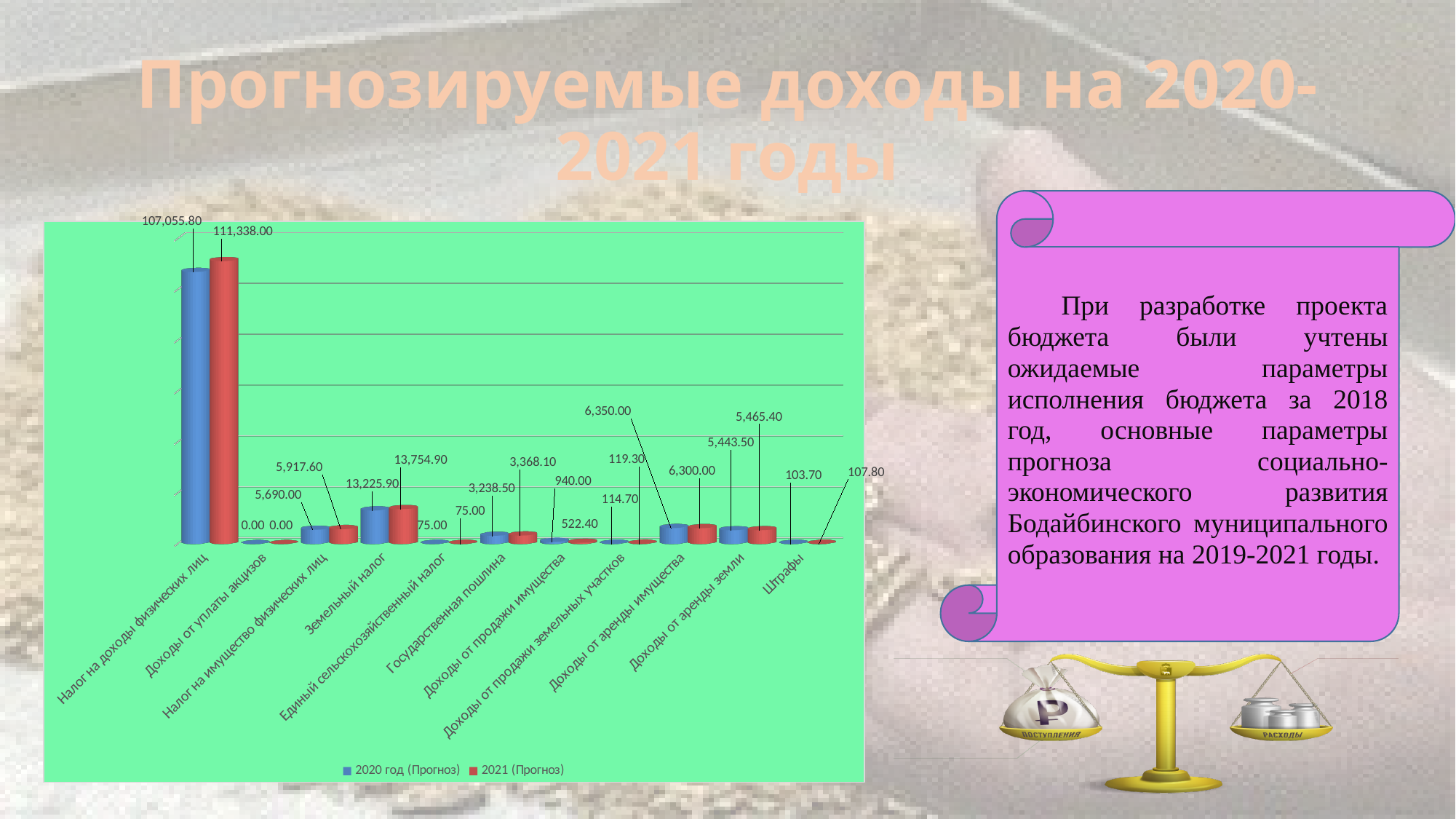
What is the difference between the 2021 (Прогноз) and 2020 год (Прогноз) values for Земельный налог? 529.00 What is the 2021 (Прогноз) value for Налог на доходы физических лиц? 111,338.00 What is the 2020 год (Прогноз) value for Доходы от продажи имущества? 940.00 How many categories are shown on the x axis? 11 What is the 2020 год (Прогноз) value for Налог на доходы физических лиц? 107,055.80 Which category has the highest 2021 (Прогноз) value? Налог на доходы физических лиц Which colour represents the 2021 (Прогноз) series? Red How many series does the legend list? 2 Which is larger for Доходы от продажи имущества: the 2020 год (Прогноз) value or the 2021 (Прогноз) value? 2020 год (Прогноз) Which category has the lowest 2020 год (Прогноз) value? Доходы от уплаты акцизов What kind of chart is shown on the slide? Bar chart What is the 2021 (Прогноз) value for Земельный налог? 13,754.90